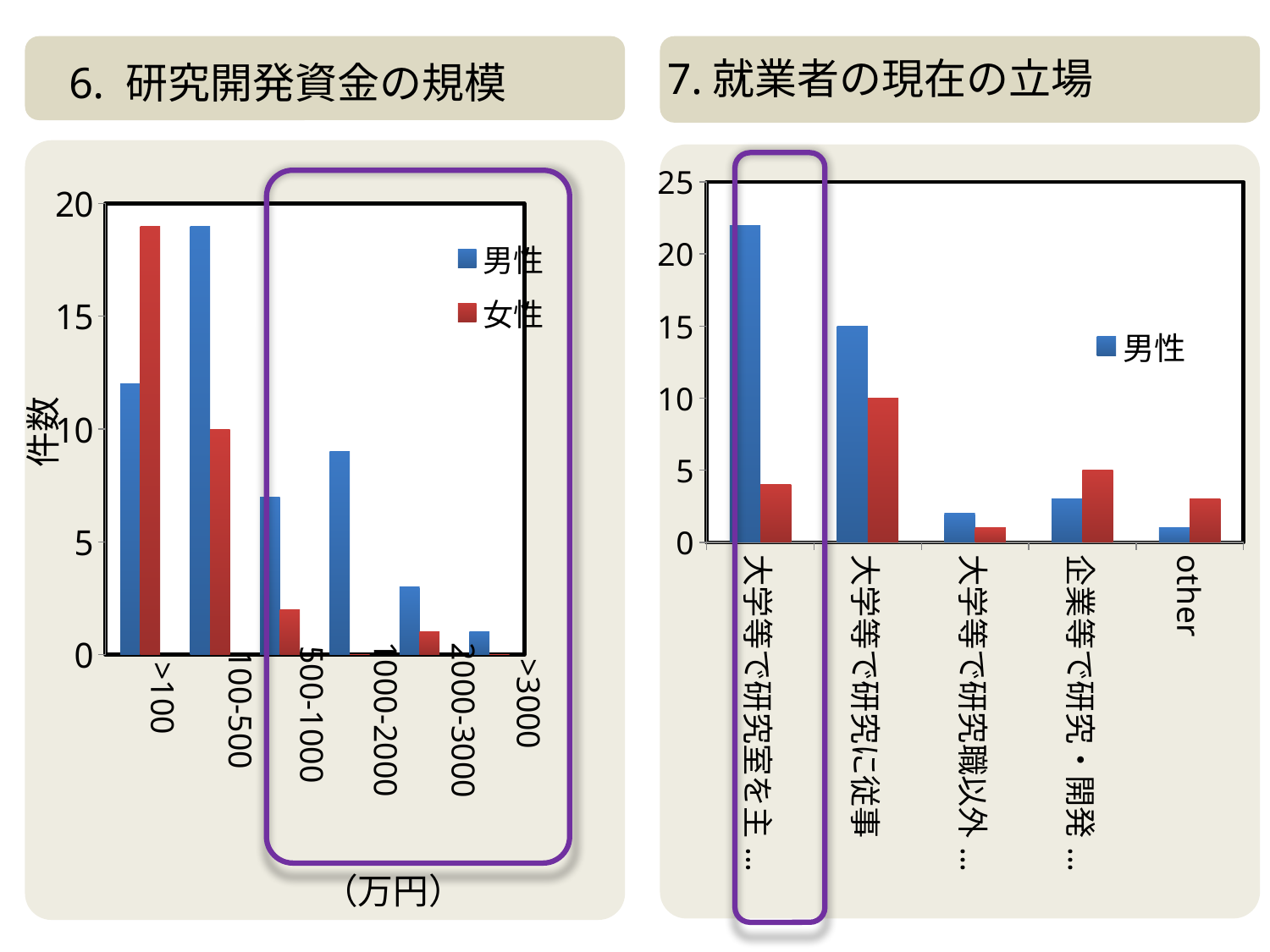
In the chart titled 7. 就業者の現在の立場, for the other category, which bar is taller, the blue bar or the red bar? red bar In the chart titled 6. 研究開発資金の規模, which category has the highest 男性 bar? 100-500 In the chart titled 7. 就業者の現在の立場, how many categories are shown on the x axis? 5 In the chart titled 6. 研究開発資金の規模, how many series does the legend list? 2 In the chart titled 6. 研究開発資金の規模, is the 男性 value for >100 greater or less than 10? greater In the chart titled 6. 研究開発資金の規模, how many categories are shown on the x axis? 6 In the chart titled 6. 研究開発資金の規模, is the 女性 value for 500-1000 greater or less than 5? less In the chart titled 6. 研究開発資金の規模, for the >100 category, which series has the larger value, 男性 or 女性? 女性 In the chart titled 7. 就業者の現在の立場, which category has the highest 男性 bar? 大学等で研究室を主… What kind of chart is the chart titled 6. 研究開発資金の規模? bar chart What is the y-axis label of the chart titled 6. 研究開発資金の規模? 件数 In the chart titled 7. 就業者の現在の立場, is the 男性 value for 大学等で研究室を主… greater or less than 20? greater